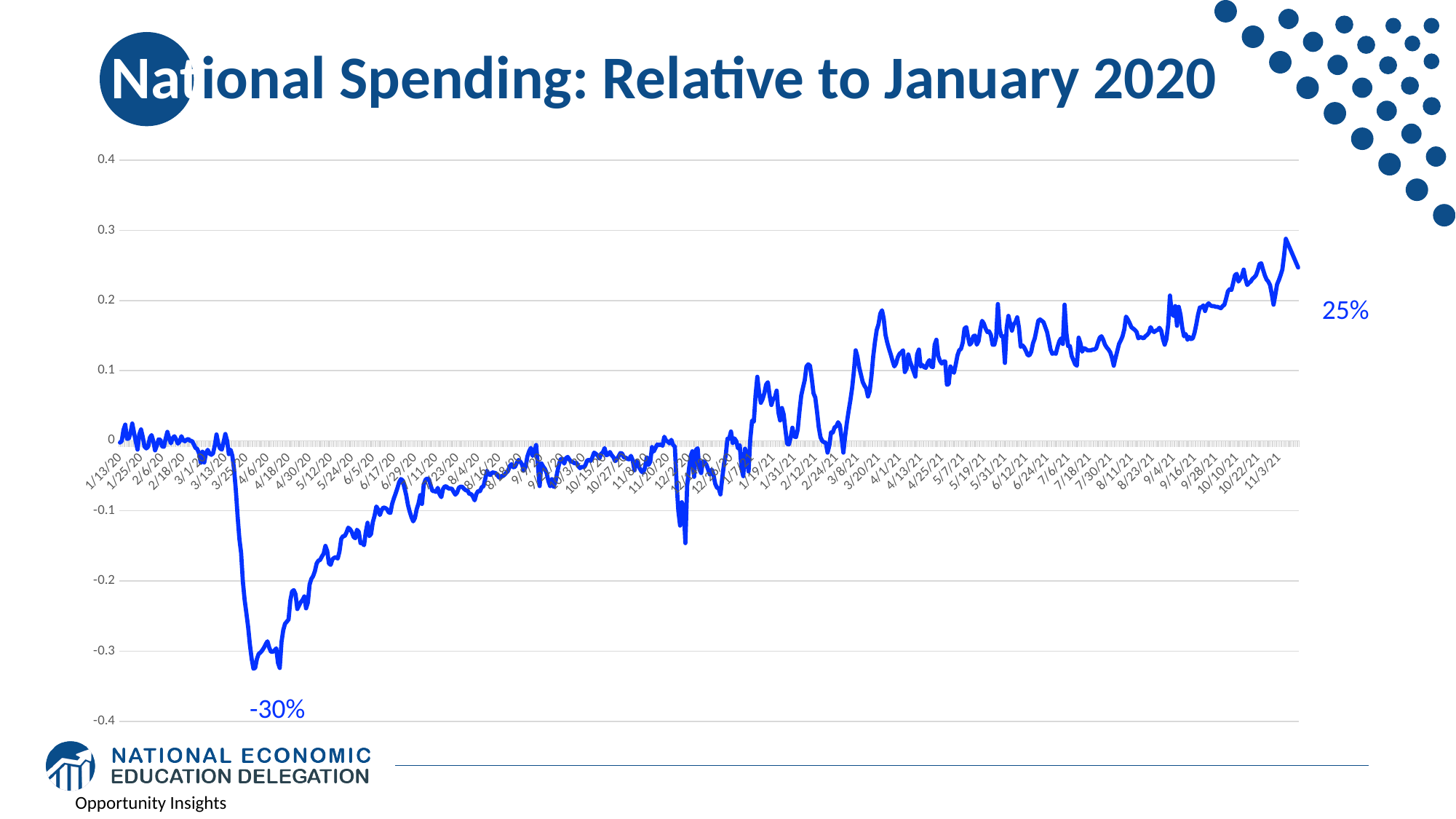
Is the value at 11/3/21 greater or less than 0.2? greater What is the title of the chart? National Spending: Relative to January 2020 Is the value around 6/29/20 greater or less than 0? less Which is larger, the value around 4/6/20 or the value around 10/22/21? 10/22/21 What is the highest tick value shown on the vertical axis? 0.4 Is the value around 8/23/21 greater or less than 0.1? greater What kind of chart is shown on the slide? line chart How many lines are plotted on the chart? 1 What value is annotated at the lowest point of the line, in spring 2020? -30% What value is annotated at the right end of the line, in late 2021? 25% Does the line generally rise or fall from its spring 2020 low to the end of 2021? rise